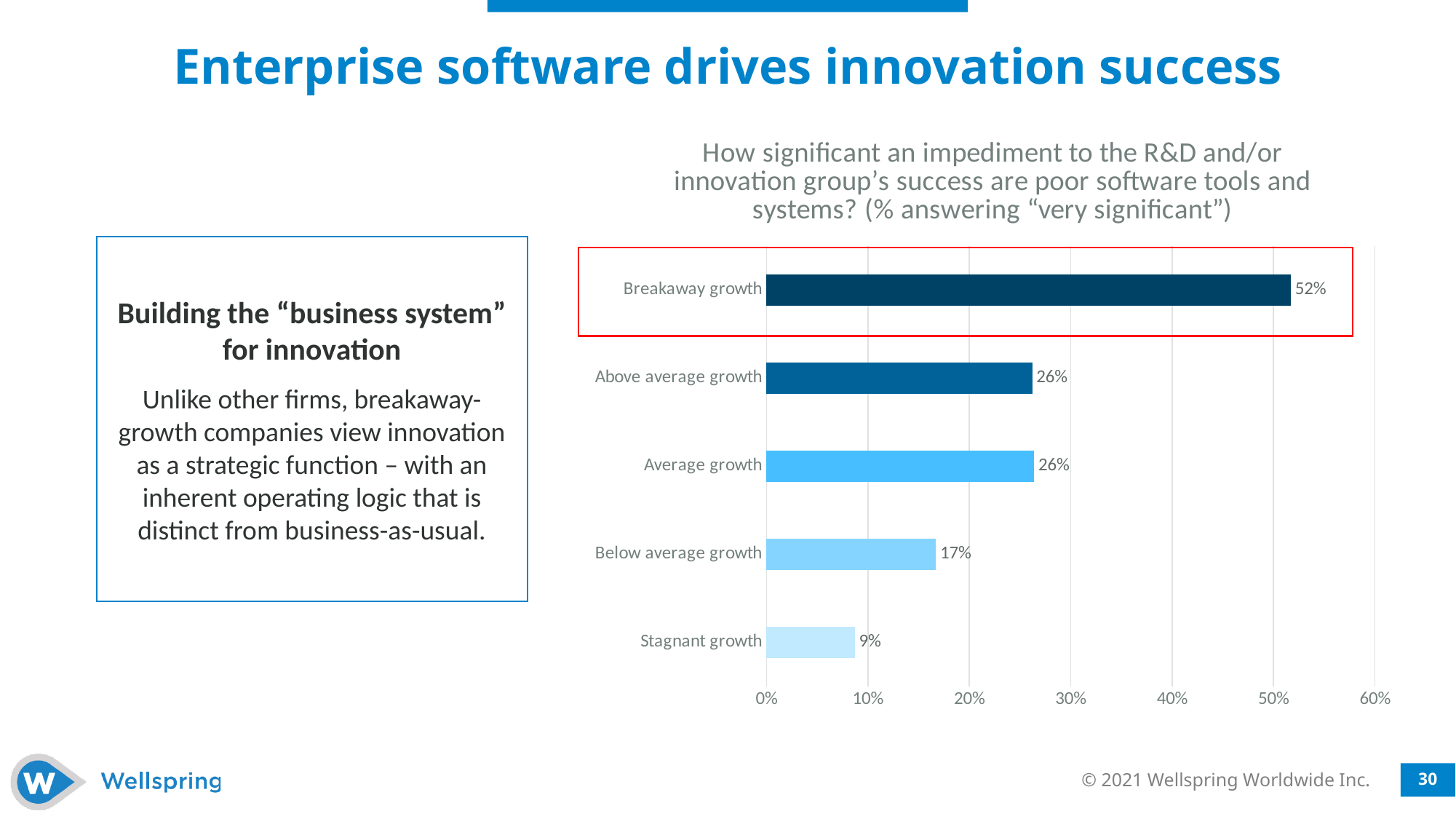
What is the difference between the values for Breakaway growth and Above average growth? 26% Which category has the lowest value? Stagnant growth How many categories are shown in the chart? 5 Which is larger, the value for Average growth or the value for Below average growth? Average growth Which category has the highest value? Breakaway growth What is the value shown for Below average growth? 17% Which category's bar is outlined with a red box? Breakaway growth What kind of chart is shown on the slide? bar chart Is the value for Breakaway growth greater or less than 50%? greater What is the value shown for Stagnant growth? 9% What percentage of Breakaway growth companies answered "very significant"? 52% What is the difference between the values for Below average growth and Stagnant growth? 8%